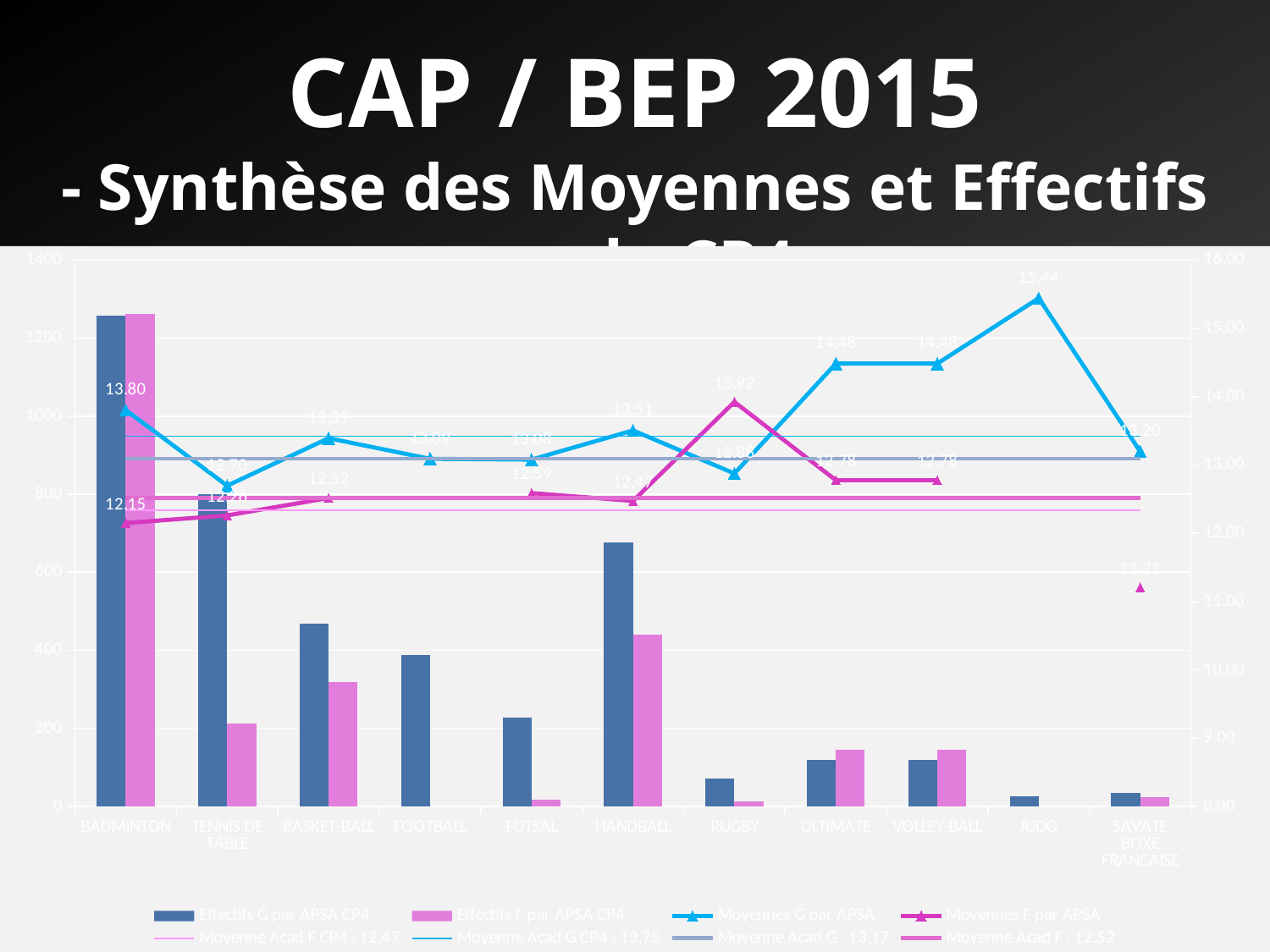
According to the legend, what is the value of Moyenne Acad G CP4? 13,75 What is the Moyennes G par APSA value for Handball? 13.51 Is the Effectifs G par APSA CP4 bar for Handball greater or less than 600? greater What kind of chart is shown on the slide? Combination bar and line chart For Badminton, which is larger: the Moyennes G par APSA value or the Moyennes F par APSA value? Moyennes G par APSA (13.80) How many sports (categories) are shown on the x axis? 11 What is the Moyennes F par APSA value for Rugby? 13.92 Which sport has the highest Moyennes G par APSA value? Judo (15.44) How many series does the legend list? 8 Is the Effectifs G par APSA CP4 bar for Badminton greater or less than 1200? greater Which sport has the lowest Moyennes F par APSA value? Savate boxe française (11.21) What is the difference between the Moyennes G and Moyennes F values for Ultimate? 1.70